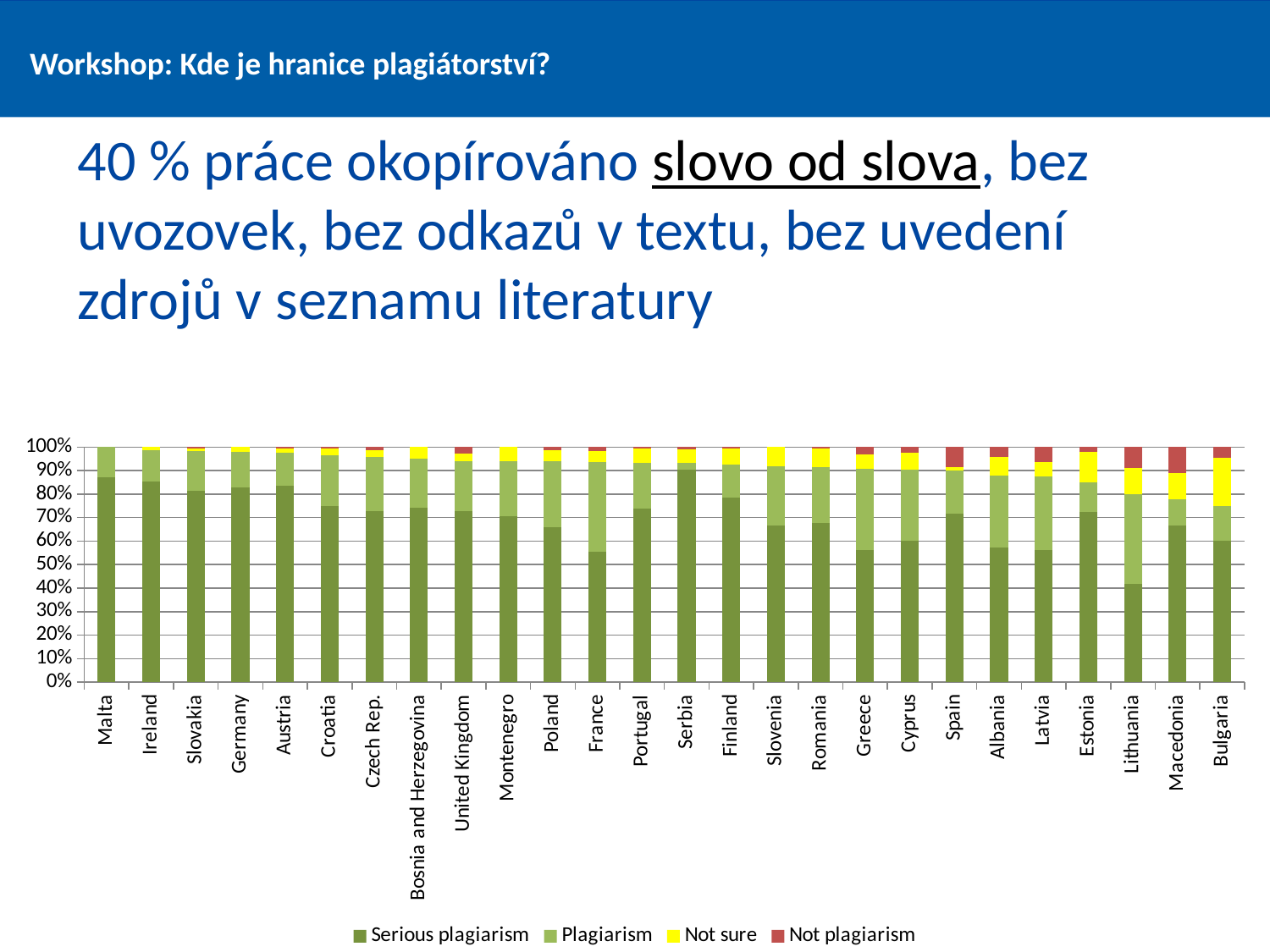
Is the 'Serious plagiarism' value for France greater or less than 50%? greater How many countries are shown on the x axis of the chart? 26 Which has a larger 'Serious plagiarism' share, Macedonia or Latvia? Macedonia Is the 'Serious plagiarism' value for Lithuania greater or less than 50%? less What is the first series listed in the chart legend? Serious plagiarism Which series is shown in yellow in the chart? Not sure What kind of chart is shown on the slide? stacked bar chart Is the 'Serious plagiarism' value for Malta greater or less than 80%? greater How many series does the chart legend list? 4 Which country has the lowest share of 'Serious plagiarism' responses? Lithuania What is the total height of each stacked bar in the chart? 100% Which has a larger 'Serious plagiarism' share, Germany or Lithuania? Germany